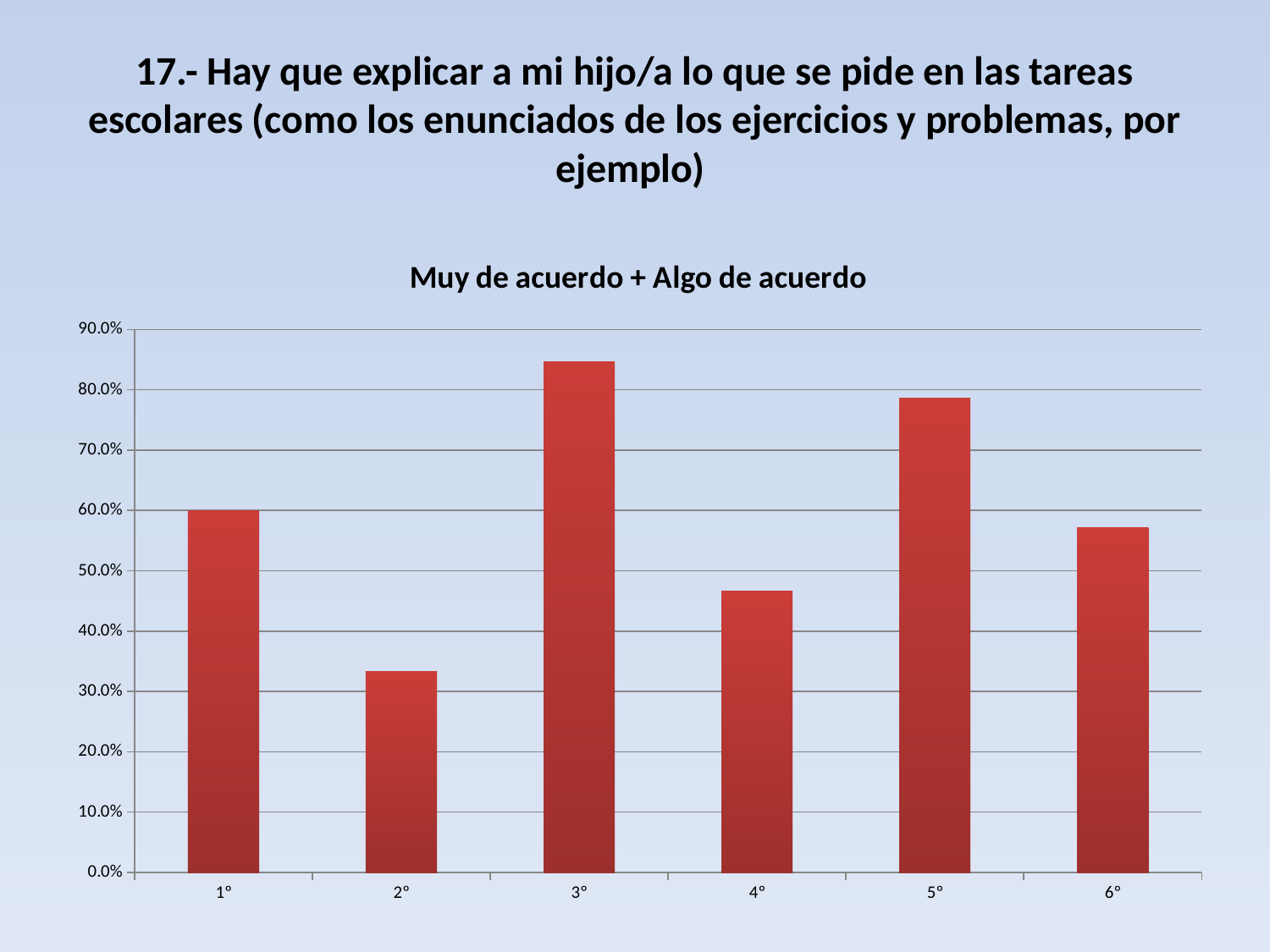
What is the highest value shown on the y axis of the chart? 90.0% Is the value for 4° greater or less than 50.0%? less Is the value for 3° greater or less than 80.0%? greater Which has a larger value, 1° or 4°? 1° Which category has the lowest value in the chart? 2° What kind of chart is shown on the slide? bar chart Which category has the highest value in the chart? 3° Is the value for 2° greater or less than 40.0%? less Which has a larger value, 5° or 6°? 5° What is the title of the chart? Muy de acuerdo + Algo de acuerdo How many categories are shown on the x axis of the chart? 6